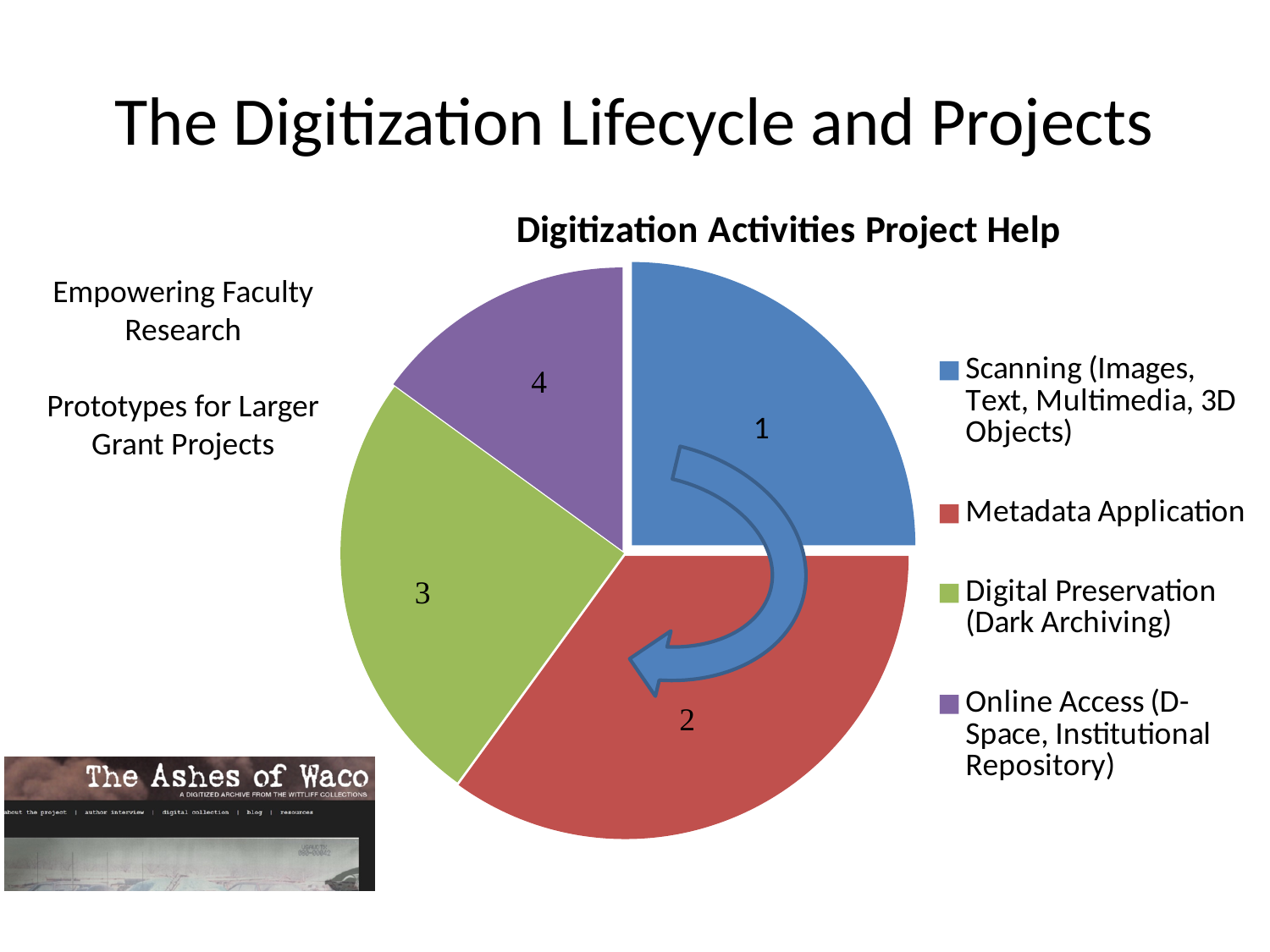
How many entries does the legend of the pie chart list? 4 Which legend entry corresponds to the slice labelled 1? Scanning (Images, Text, Multimedia, 3D Objects) Which legend entry corresponds to the slice labelled 2? Metadata Application Which slice of the pie chart is the smallest? Online Access (D-Space, Institutional Repository) Which slice of the pie chart is the largest? Metadata Application Which legend entry corresponds to the slice labelled 4? Online Access (D-Space, Institutional Repository) What is the title of the pie chart? Digitization Activities Project Help Which is larger in the pie chart: the Metadata Application slice or the Online Access (D-Space, Institutional Repository) slice? Metadata Application How many slices does the pie chart have? 4 Which legend entry corresponds to the slice labelled 3? Digital Preservation (Dark Archiving) What kind of chart is shown on the slide? pie chart What colour is the Digital Preservation (Dark Archiving) slice in the pie chart? green